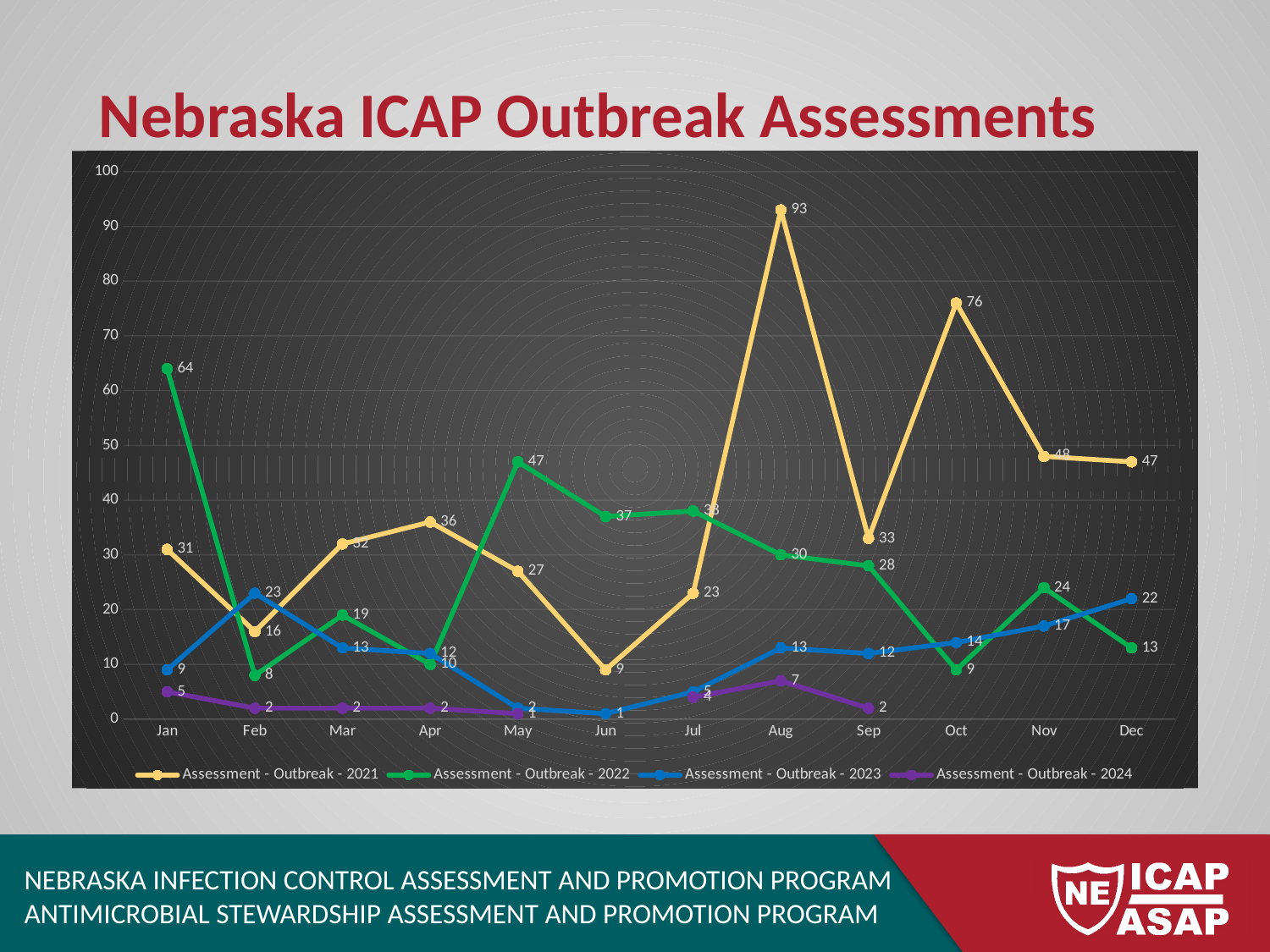
Is the value for Assessment - Outbreak - 2022 in May greater or less than 40? greater In Jan, which series has the larger value: Assessment - Outbreak - 2021 or Assessment - Outbreak - 2022? Assessment - Outbreak - 2022 What is the value for Assessment - Outbreak - 2021 in Aug? 93 In which month does Assessment - Outbreak - 2021 have its lowest value? Jun What kind of chart is shown on the slide? line chart What is the value for Assessment - Outbreak - 2024 in Aug? 7 How many months are shown on the x axis? 12 In which month does Assessment - Outbreak - 2021 reach its highest value? Aug What is the difference between the Aug and Oct values for Assessment - Outbreak - 2021? 17 How many series does the legend list? 4 What is the value for Assessment - Outbreak - 2023 in Dec? 22 What is the value for Assessment - Outbreak - 2022 in Jan? 64